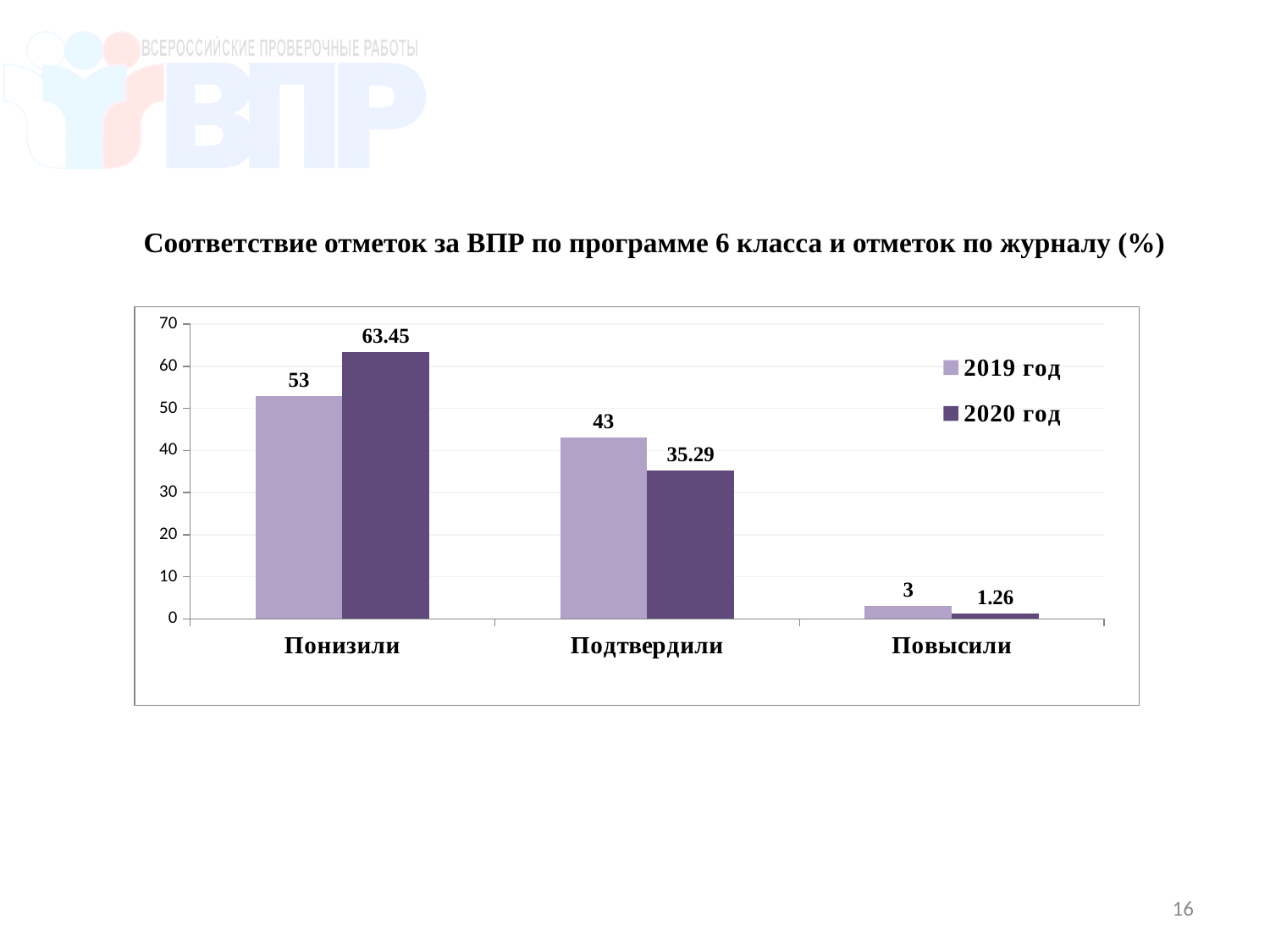
Is the 2020 год value for Подтвердили greater or less than 40? less What is the difference between the 2020 год and 2019 год values for Понизили? 10.45 Which category has the lowest value in the 2019 год series? Повысили How many categories are shown on the x axis? 3 What is the value for Понизили in the 2019 год series? 53 What is the value for Подтвердили in the 2020 год series? 35.29 How many series does the legend list? 2 Which category has the highest value in the 2020 год series? Понизили What kind of chart is shown on the slide? bar chart What is the value for Понизили in the 2020 год series? 63.45 Which is larger for Подтвердили: the 2019 год value or the 2020 год value? 2019 год What is the value for Повысили in the 2019 год series? 3